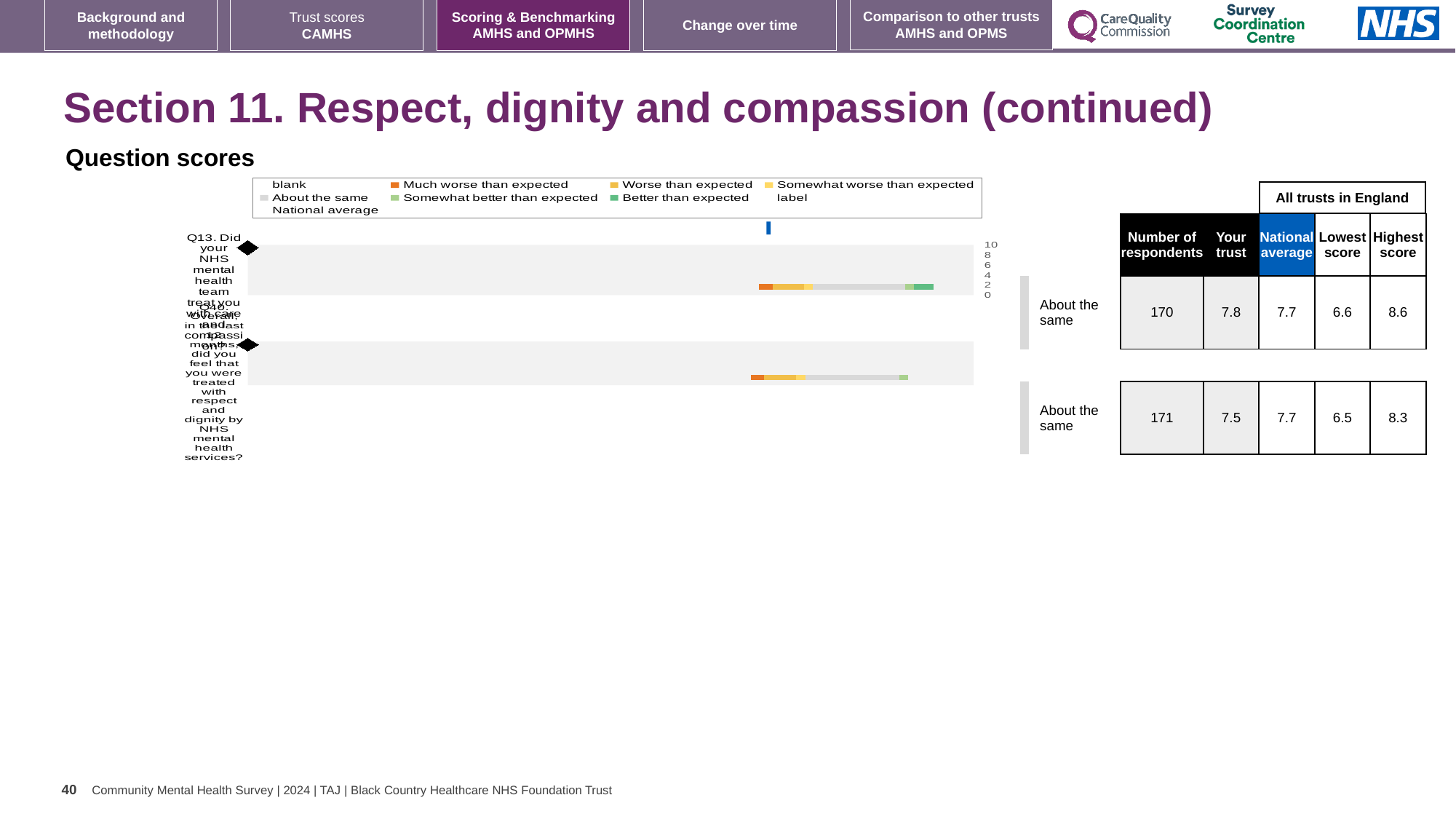
Which two questions are plotted in the question scores chart? Q13 and Q10 What benchmark category is shown for Q13 and Q10? About the same How many respondents answered Q10? 171 What is the difference between the 'Your trust' scores for Q13 and Q10? 0.3 What is the highest score across all trusts in England for Q10? 8.3 What is the national average score for Q13? 7.7 How many questions are plotted in the question scores chart? 2 What kind of chart is used to show the question scores on this slide? bar chart Which question has the higher 'Your trust' score, Q13 or Q10? Q13 What is the 'Your trust' score for Q13? 7.8 What is the lowest score across all trusts in England for Q13? 6.6 What is the 'Your trust' score for Q10? 7.5